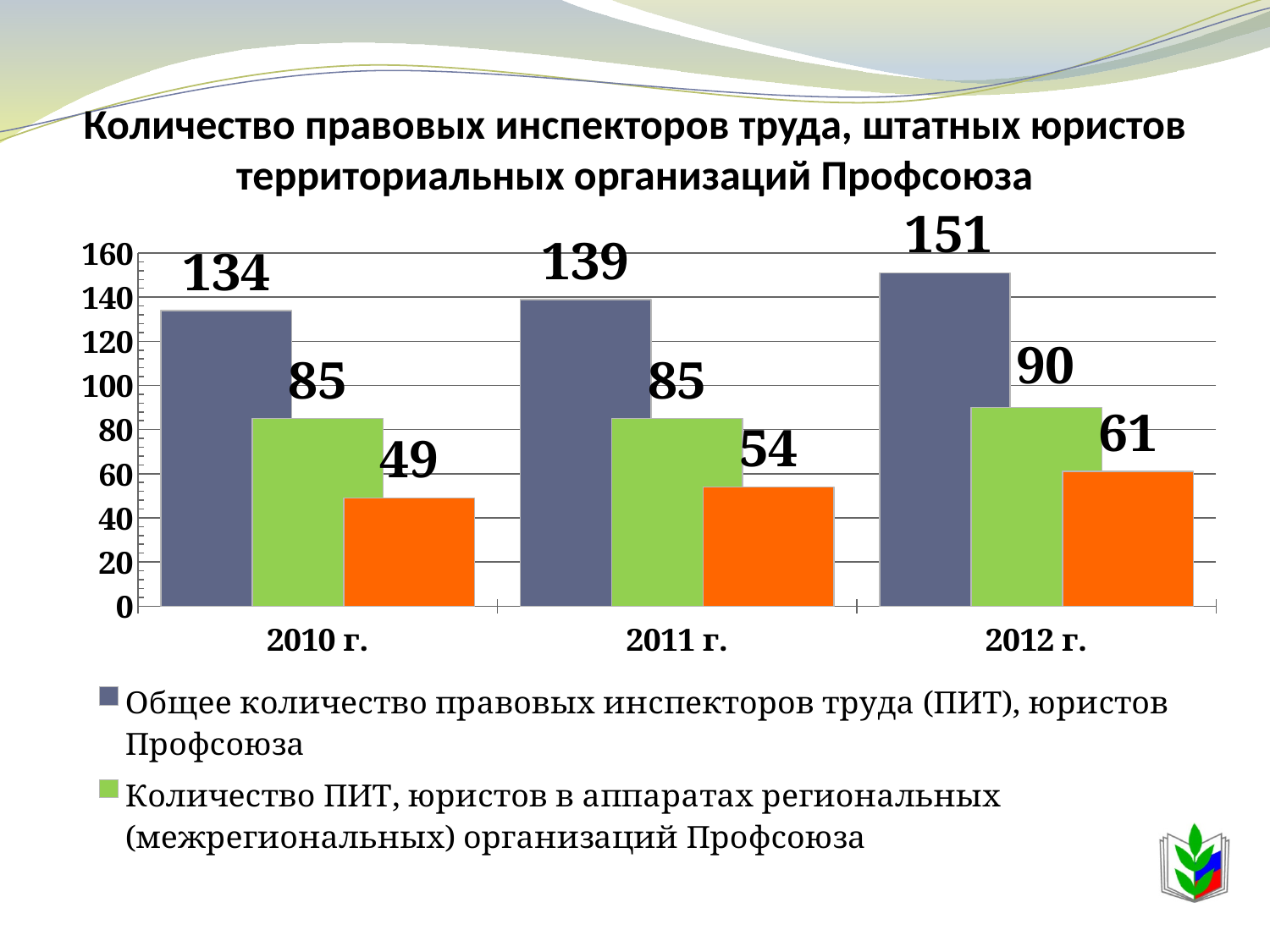
How many years are shown on the x axis of the chart? 3 What is the value of the green bar (Количество ПИТ, юристов в аппаратах региональных (межрегиональных) организаций Профсоюза) for 2011 г.? 85 In which year is the total number of legal labour inspectors and lawyers (dark blue bar) the highest? 2012 г. By how much did the total number (dark blue bar) increase from 2010 г. to 2012 г.? 17 Does the total number (dark blue bar) rise or fall from 2010 г. to 2012 г.? Rises For 2011 г., which is larger: the dark blue bar or the green bar? The dark blue bar (139) What is the value of the dark blue bar (Общее количество правовых инспекторов труда (ПИТ), юристов Профсоюза) for 2010 г.? 134 What is the difference between the green bar values for 2012 г. and 2011 г.? 5 What is the value of the green bar (Количество ПИТ, юристов в аппаратах региональных (межрегиональных) организаций Профсоюза) for 2012 г.? 90 In which year is the total number of legal labour inspectors and lawyers (dark blue bar) the lowest? 2010 г. What is the value of the dark blue bar (Общее количество правовых инспекторов труда (ПИТ), юристов Профсоюза) for 2012 г.? 151 What type of chart is shown on the slide? Bar chart